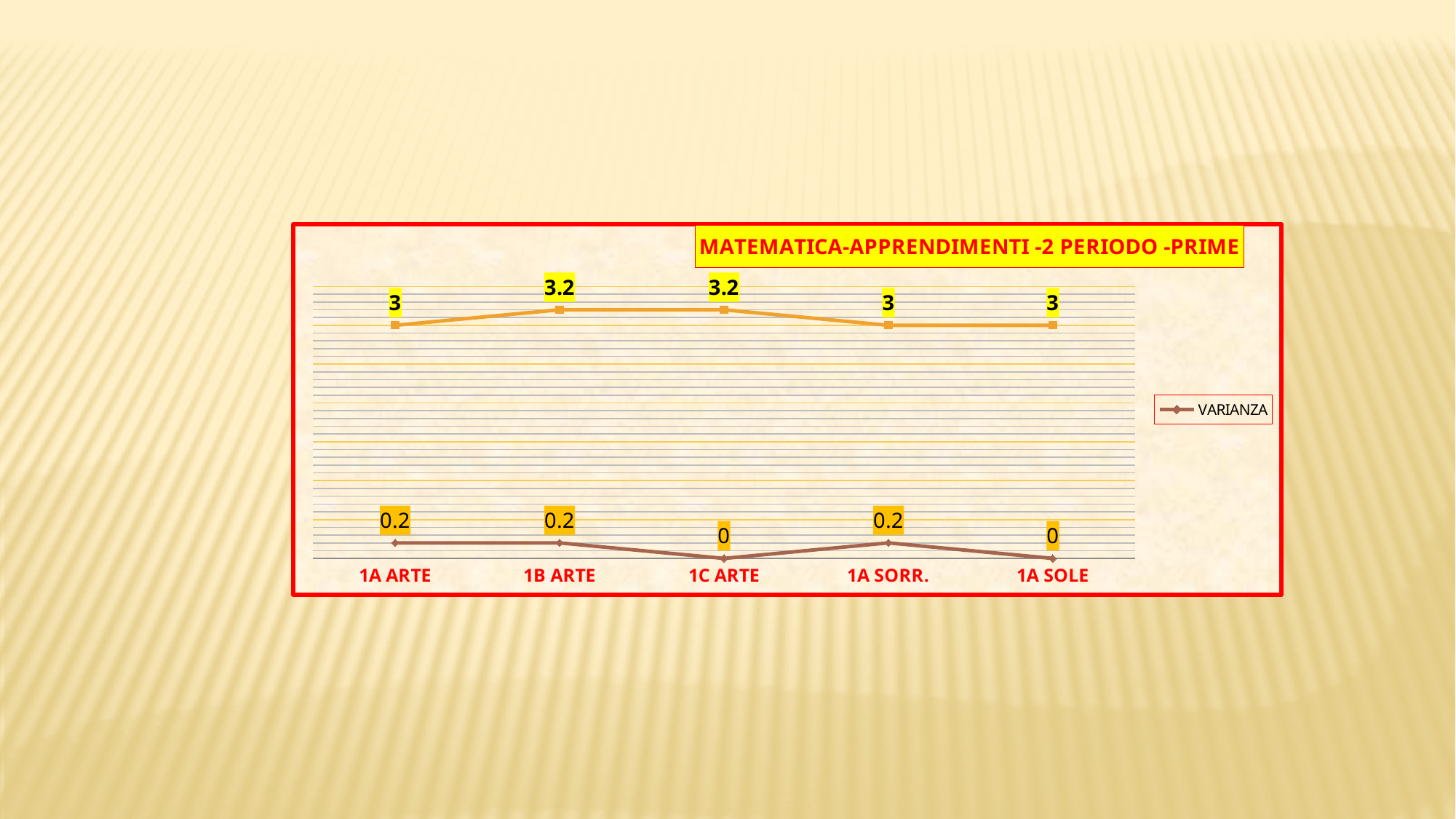
What is the difference between the VARIANZA values for 1B ARTE and 1C ARTE? 0.2 What kind of chart is shown on the slide? line chart What is the value of the upper orange line for 1A SOLE? 3 What is the VARIANZA value for 1A SORR.? 0.2 What is the VARIANZA value for 1C ARTE? 0 How many categories are shown on the x axis? 5 What is the VARIANZA value for 1A ARTE? 0.2 What is the title of the chart? MATEMATICA-APPRENDIMENTI -2 PERIODO -PRIME What is the value of the upper orange line for 1B ARTE? 3.2 What is the VARIANZA value for 1A SOLE? 0 Which is larger, the VARIANZA value for 1A SORR. or for 1A SOLE? 1A SORR. How many series does the legend list? 1